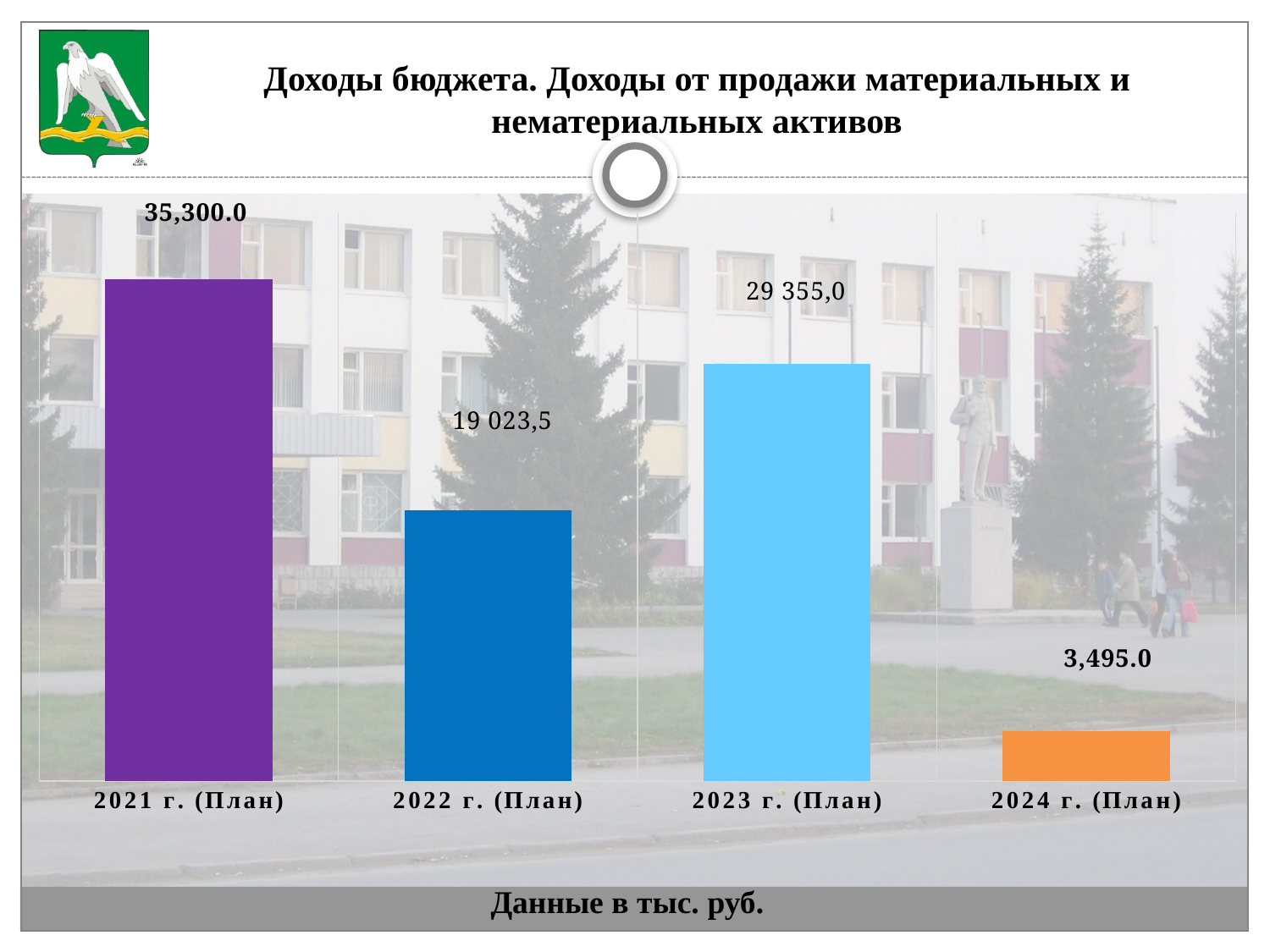
Which year has the highest value? 2021 г. (План) What is the value for 2021 г. (План)? 35,300.0 What is the value for 2024 г. (План)? 3,495.0 What is the difference between the values for 2021 г. (План) and 2024 г. (План)? 31,805.0 Which year has the lowest value? 2024 г. (План) In what units are the chart's data given, according to the slide? тыс. руб. Which is larger, the value for 2022 г. (План) or 2023 г. (План)? 2023 г. (План) What kind of chart is shown on the slide? Bar chart What is the difference between the values for 2023 г. (План) and 2022 г. (План)? 10 331,5 What is the value for 2022 г. (План)? 19 023,5 What is the value for 2023 г. (План)? 29 355,0 How many bars are shown in the chart? 4